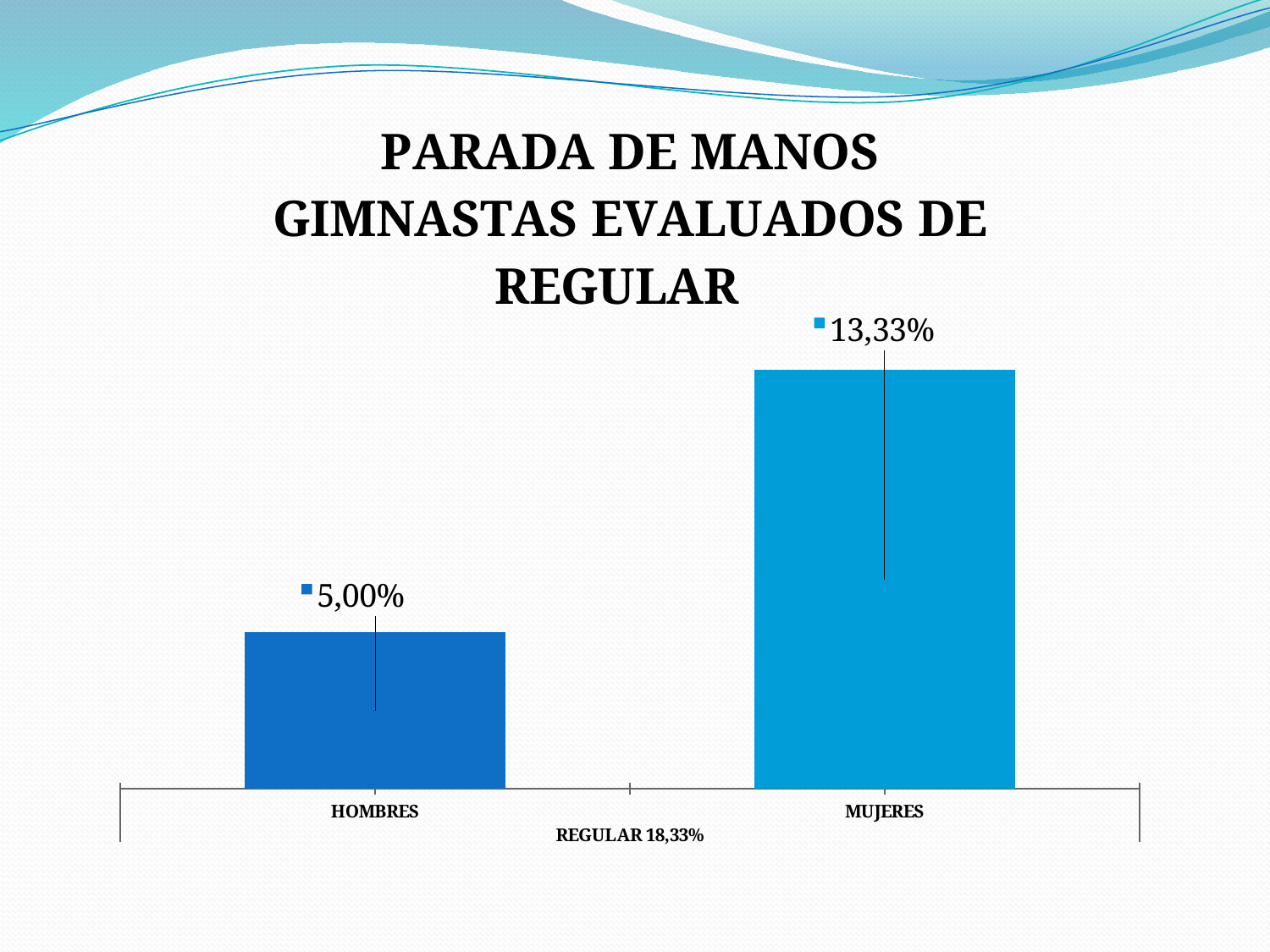
How many categories are shown in the chart? 2 Which is larger, the value for HOMBRES or the value for MUJERES? MUJERES What is the title of the chart? PARADA DE MANOS GIMNASTAS EVALUADOS DE REGULAR What is the value for MUJERES? 13,33% What label appears below the category axis? REGULAR 18,33% Which category has the lowest value? HOMBRES What kind of chart is shown on the slide? Bar chart What is the total of the values for HOMBRES and MUJERES? 18,33% Which category has the highest value? MUJERES What is the difference between the values for MUJERES and HOMBRES? 8,33% What is the value for HOMBRES? 5,00%